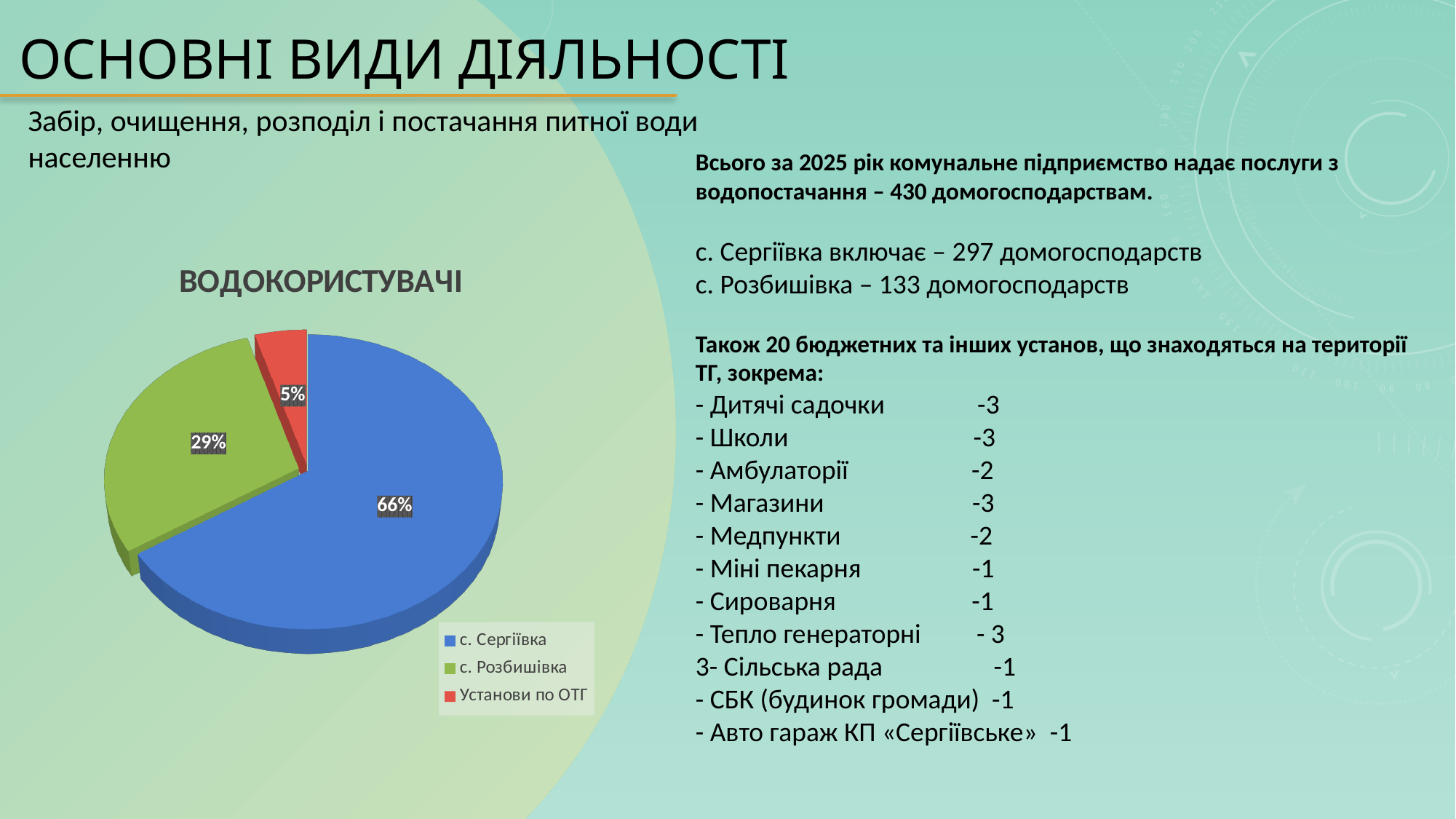
Which is larger, the share for с. Розбишівка or the share for Установи по ОТГ? с. Розбишівка What type of chart is shown on the slide? Pie chart What share of the pie does Установи по ОТГ have? 5% What share of the pie does с. Розбишівка have? 29% Which category has the largest slice of the pie? с. Сергіївка What is the title of the chart? ВОДОКОРИСТУВАЧІ What is the difference in percentage points between с. Сергіївка and с. Розбишівка? 37 What share of the pie does с. Сергіївка have? 66% What is the difference in percentage points between с. Розбишівка and Установи по ОТГ? 24 How many categories does the pie chart show? 3 What colour is the slice for с. Розбишівка? Green Which category has the smallest slice of the pie? Установи по ОТГ